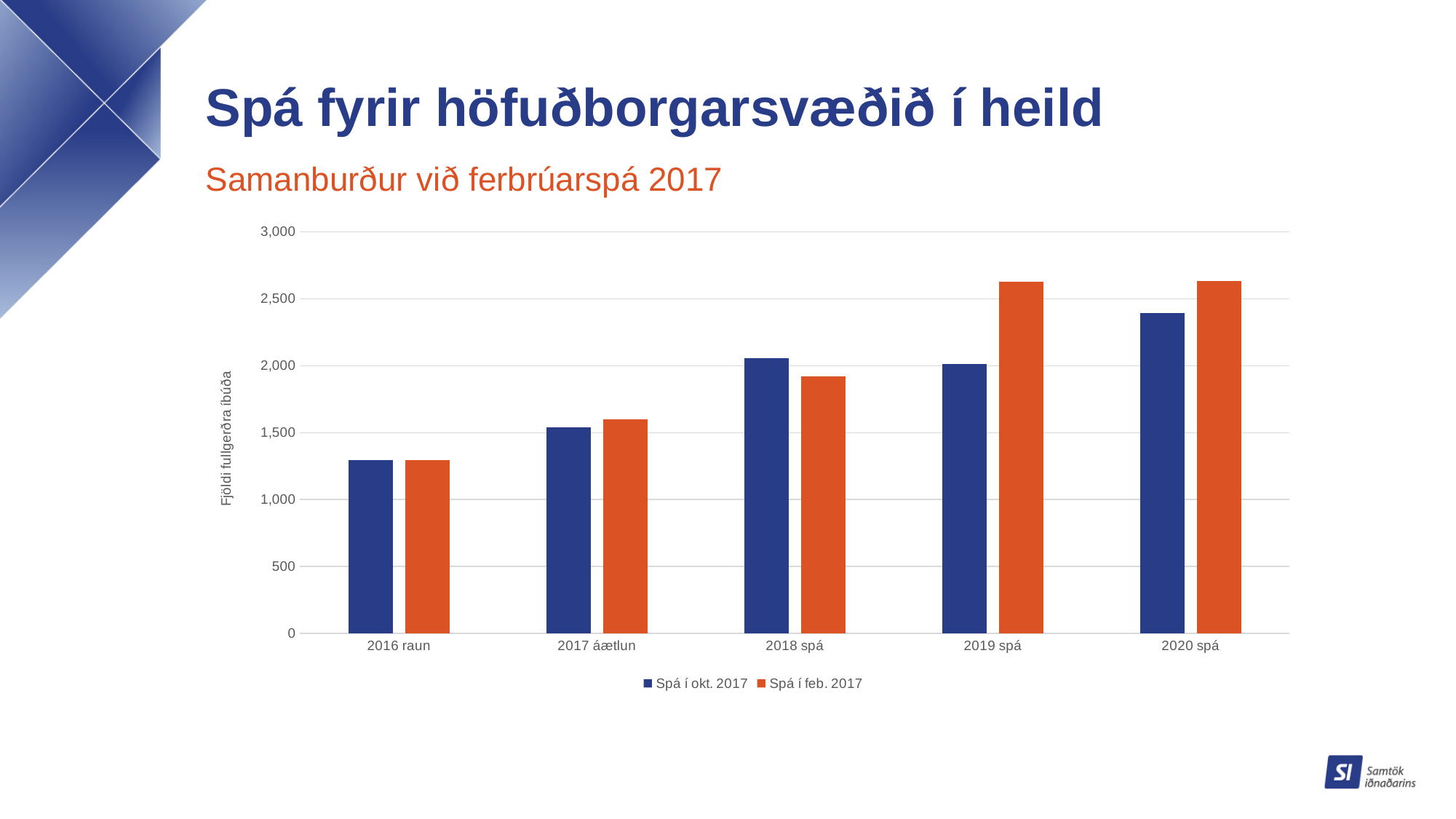
Is the value for Spá í okt. 2017 in 2018 spá greater or less than 2,000? greater How many categories are shown on the x axis? 5 Is the value for Spá í okt. 2017 in 2016 raun greater or less than 1,500? less What is the label on the vertical axis of the chart? Fjöldi fullgerðra íbúða For 2019 spá, which series has the larger value, Spá í okt. 2017 or Spá í feb. 2017? Spá í feb. 2017 Do the values for Spá í feb. 2017 rise or fall from 2016 raun to 2020 spá? rise For 2018 spá, which series has the larger value, Spá í okt. 2017 or Spá í feb. 2017? Spá í okt. 2017 What kind of chart is shown on the slide? bar chart How many series does the legend list? 2 Which category has the highest value for Spá í okt. 2017? 2020 spá Which category has the lowest value for Spá í feb. 2017? 2016 raun Is the value for Spá í feb. 2017 in 2019 spá greater or less than 2,500? greater